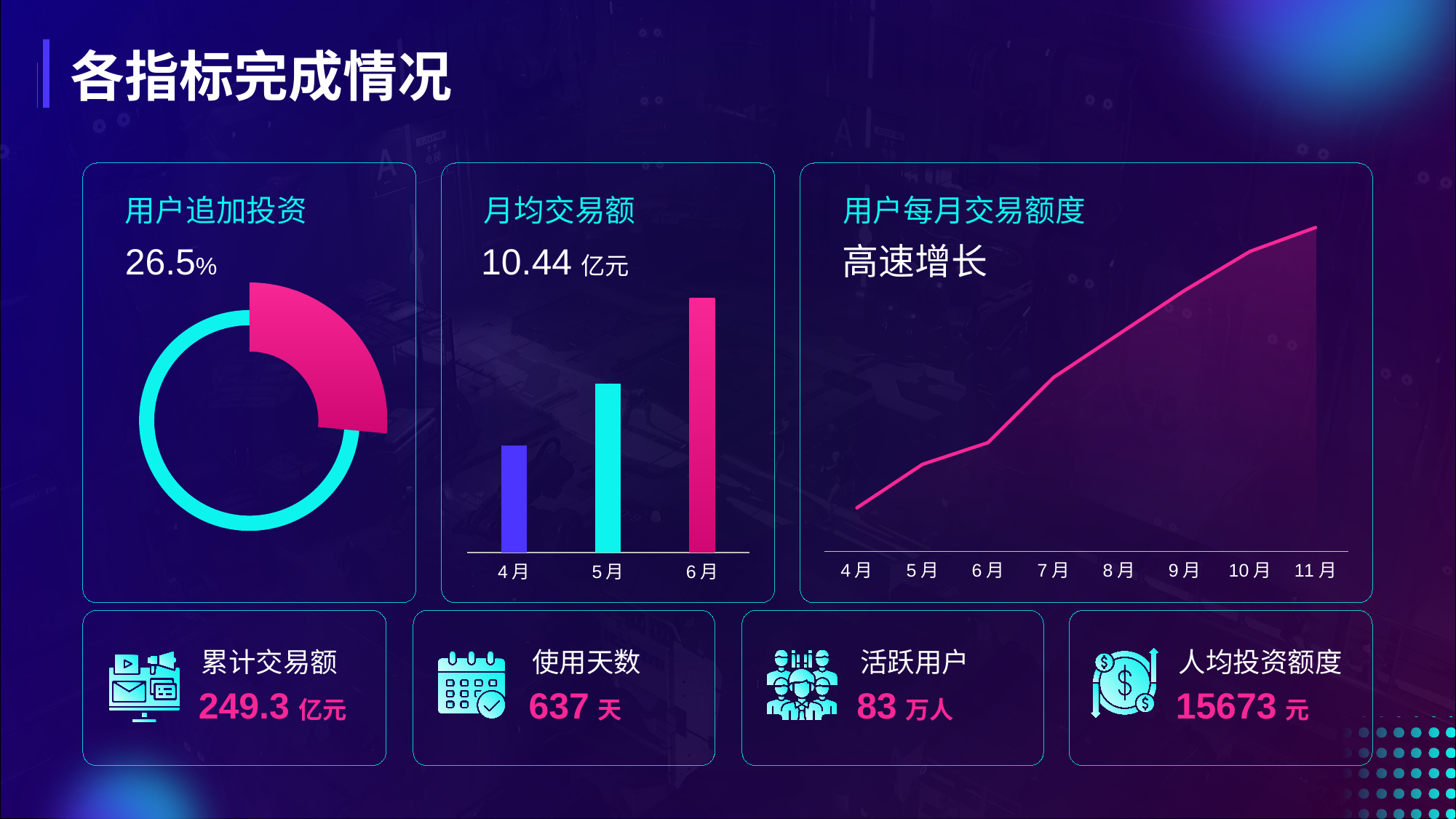
What kind of chart is shown under the title 用户每月交易额度? line chart In the 用户每月交易额度 line chart, which month has the highest point? 11月 In the 用户每月交易额度 line chart, how many months are labelled on the x axis? 8 In the 用户每月交易额度 line chart, does the line rise or fall from 4月 to 11月? rise In the 月均交易额 bar chart, which bar is taller, 4月 or 5月? 5月 In the 月均交易额 bar chart, how many months are shown on the x axis? 3 In the 月均交易额 bar chart, which month has the shortest bar? 4月 What kind of chart is shown under the title 月均交易额? bar chart What is the title of the chart on the left of the slide, above the donut chart? 用户追加投资 In the 用户追加投资 donut chart, what share does the highlighted pink segment represent? 26.5% In the 月均交易额 bar chart, do the bars rise or fall from 4月 to 6月? rise In the 月均交易额 bar chart, which month has the tallest bar? 6月